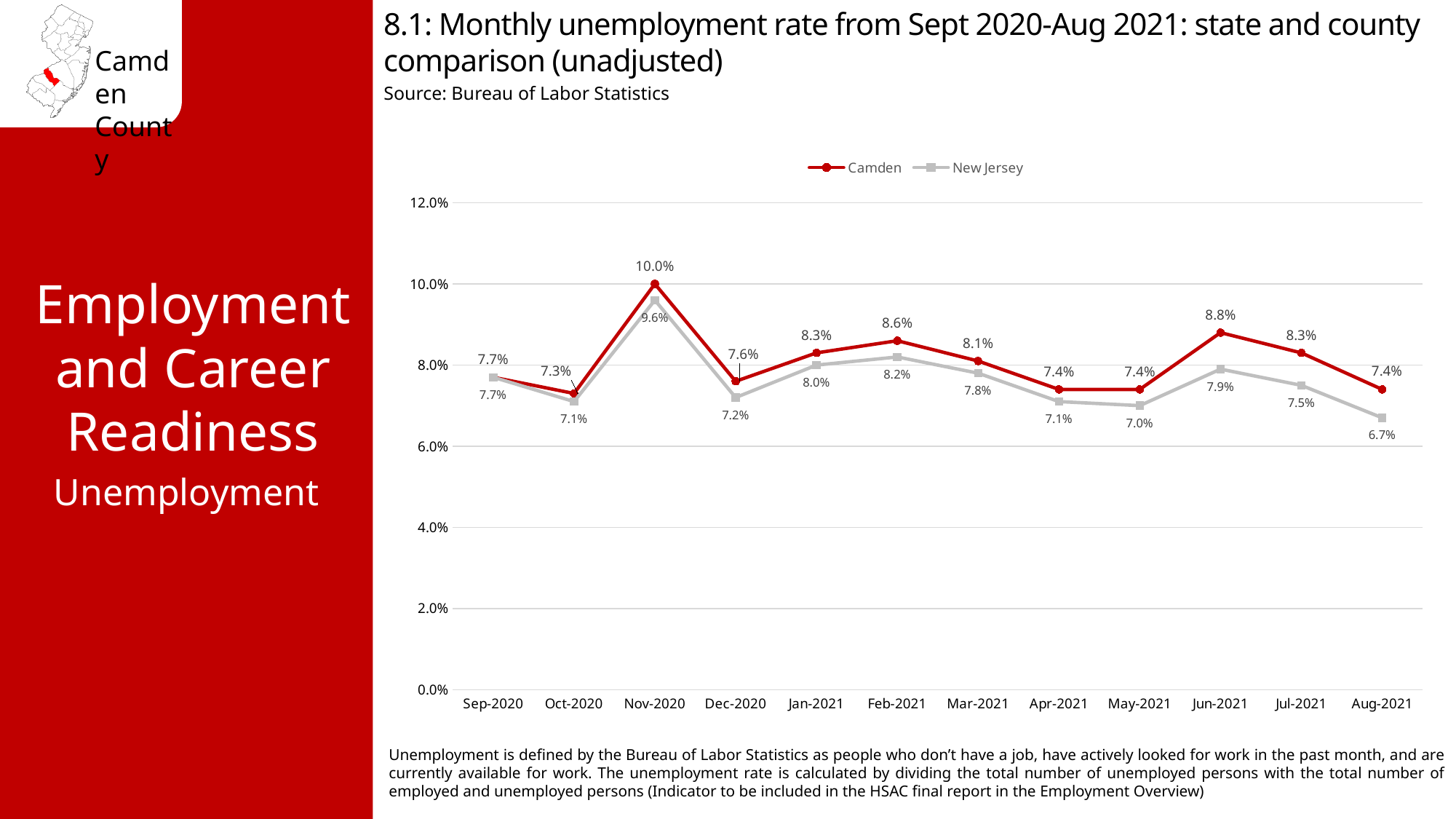
What was the New Jersey unemployment rate in Feb-2021? 8.2% In which month did Camden have its highest unemployment rate? Nov-2020 What is the difference between the Camden and New Jersey unemployment rates in Jun-2021? 0.9% How many series does the legend list? 2 What was the New Jersey unemployment rate in Aug-2021? 6.7% In which month did New Jersey have its lowest unemployment rate? Aug-2021 Which had the higher unemployment rate in Mar-2021, Camden or New Jersey? Camden What was the Camden unemployment rate in Jun-2021? 8.8% What was the Camden unemployment rate in Nov-2020? 10.0% What kind of chart is shown on the slide? Line chart How many months are shown on the x axis? 12 Did the Camden unemployment rate rise or fall from Jun-2021 to Aug-2021? Fall